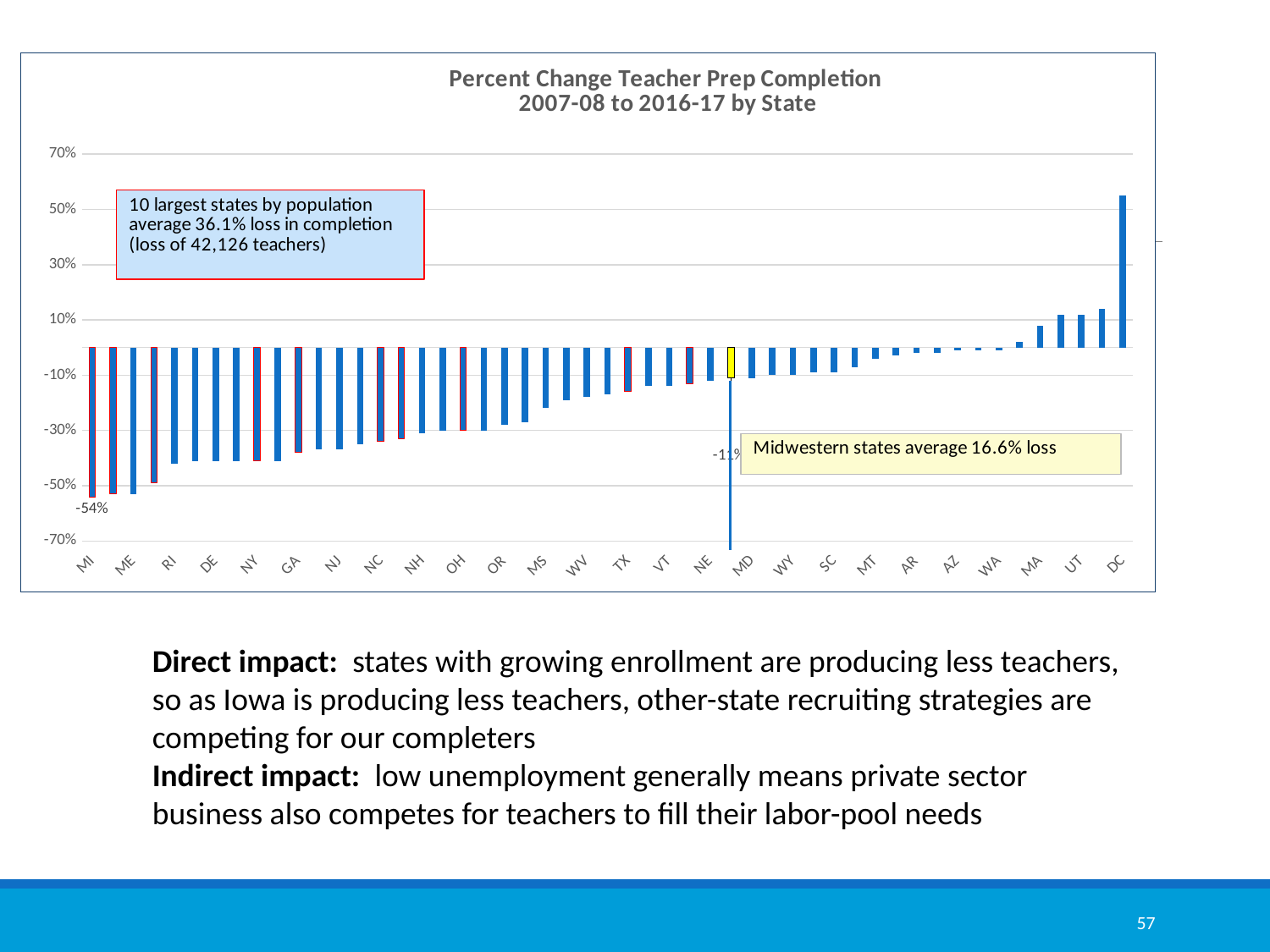
Which has the larger percent change, NY or UT? UT Do the values generally rise or fall moving from left to right along the x axis? rise Which has the larger percent change, MI or DC? DC Which state has the highest percent change in teacher prep completion? DC Is the value for NY greater or less than -30%? less Is the value for DC greater or less than 30%? greater According to the annotation on the chart, what is the average loss in completion for the 10 largest states by population? 36.1% What is the title of the chart? Percent Change Teacher Prep Completion 2007-08 to 2016-17 by State Is the value for ME greater or less than -30%? less Which state has the lowest percent change in teacher prep completion? MI What is the percent change in teacher prep completion for MI? -54% What kind of chart is shown on the slide? bar chart